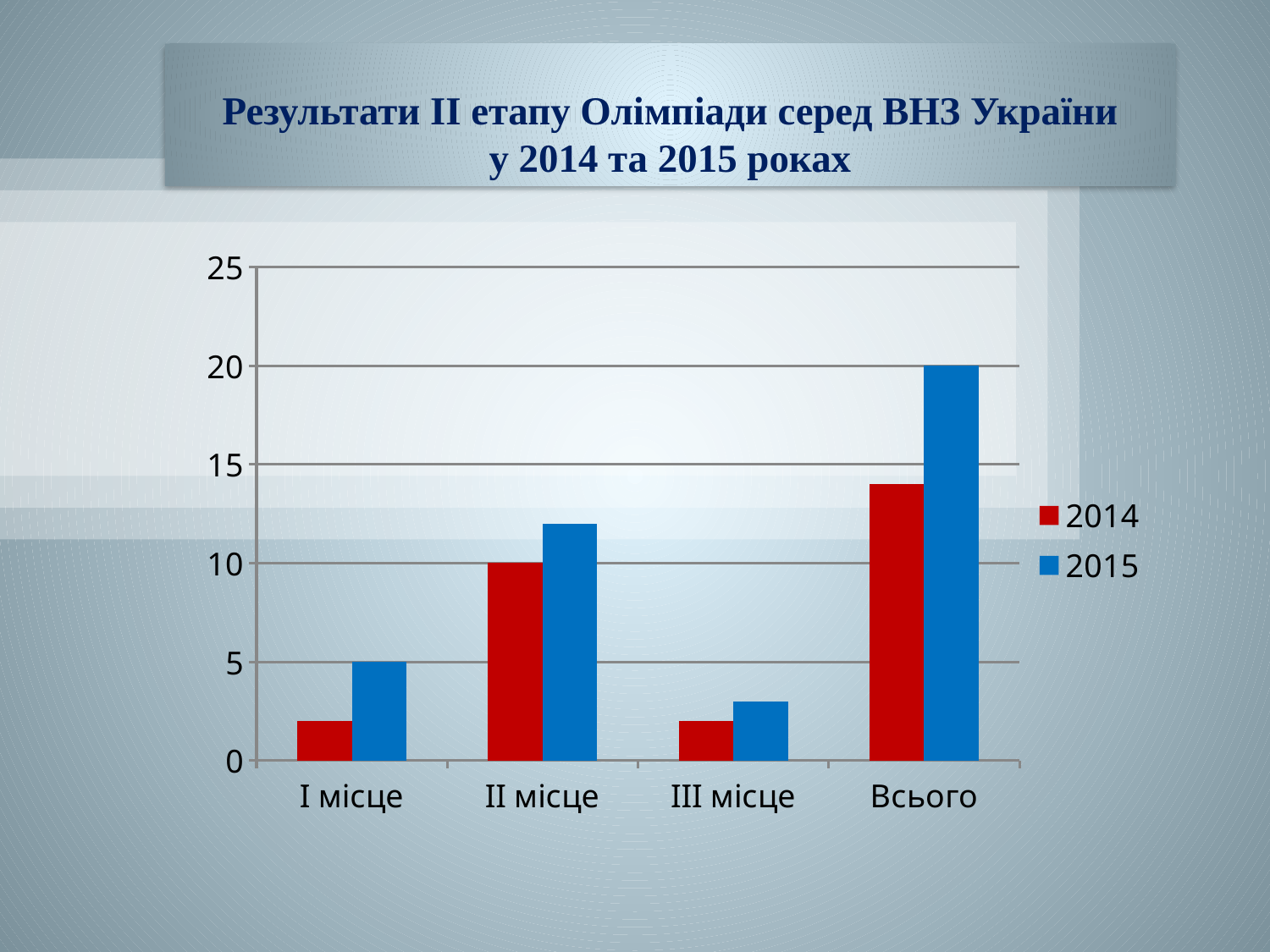
How many series does the legend list? 2 What is the value for 2014 in the "II місце" category? 10 Is the value for 2014 in the "Всього" category greater or less than 15? less Which category has the highest value for the 2015 series? Всього What kind of chart is shown on the slide? bar chart What is the value for 2015 in the "I місце" category? 5 Which series is shown in red in the legend? 2014 Which is larger in the "I місце" category, the 2014 value or the 2015 value? 2015 What is the value for 2015 in the "Всього" category? 20 How many categories are shown on the x axis? 4 Is the value for 2015 in the "II місце" category greater or less than 10? greater Is the value for 2014 in the "III місце" category greater or less than 5? less